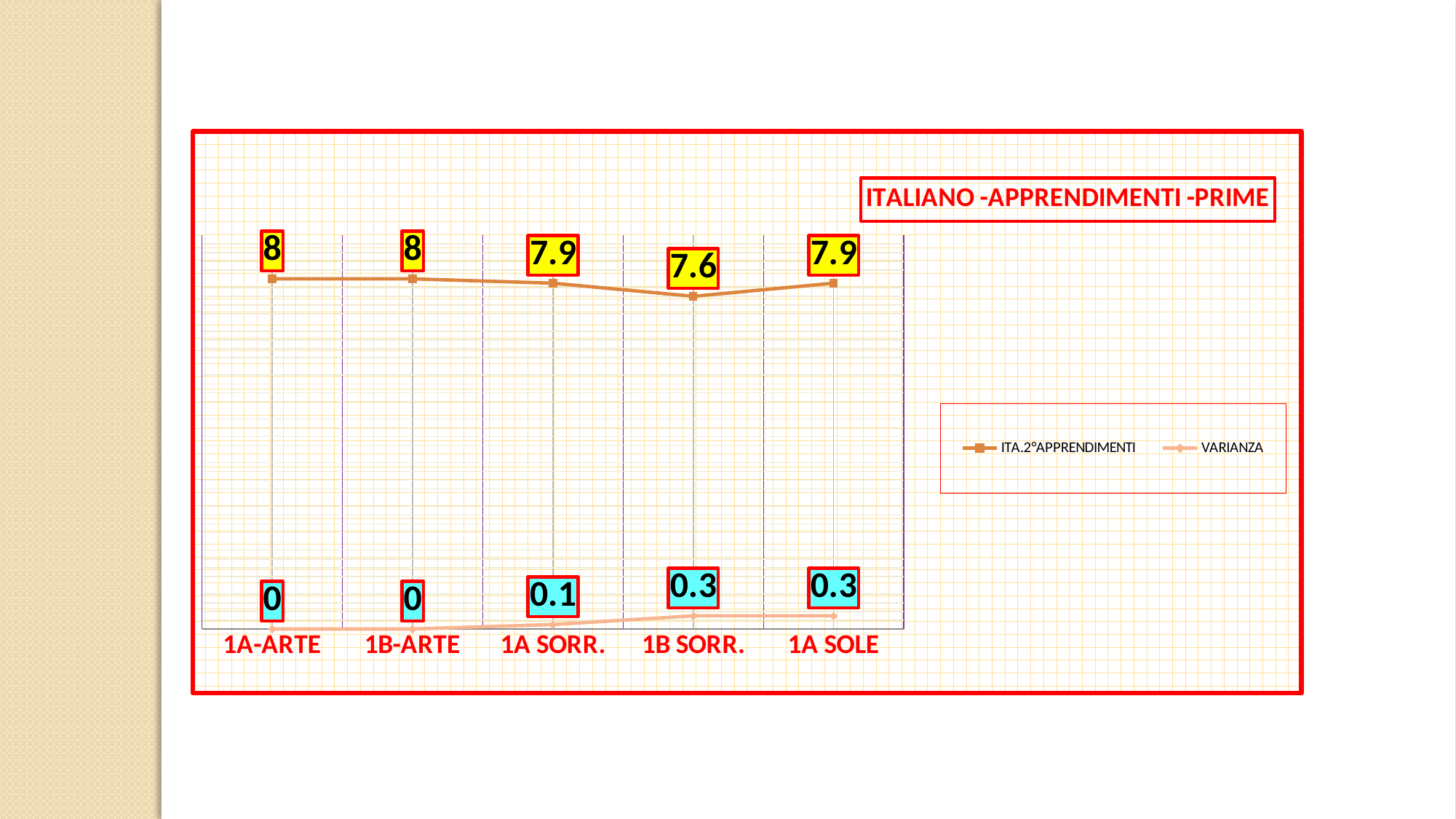
Which is larger, the ITA.2°APPRENDIMENTI value for 1B-ARTE or for 1A SOLE? 1B-ARTE What is the ITA.2°APPRENDIMENTI value for 1A SORR.? 7.9 What is the title of the chart? ITALIANO -APPRENDIMENTI -PRIME What is the difference between the ITA.2°APPRENDIMENTI values for 1A-ARTE and 1B SORR.? 0.4 What is the ITA.2°APPRENDIMENTI value for 1B SORR.? 7.6 What is the VARIANZA value for 1A SORR.? 0.1 Which category has the lowest ITA.2°APPRENDIMENTI value? 1B SORR. What is the difference between the VARIANZA values for 1B SORR. and 1A SORR.? 0.2 What kind of chart is shown on the slide? line chart What is the VARIANZA value for 1A SOLE? 0.3 How many categories are shown on the x axis? 5 How many series does the legend list? 2